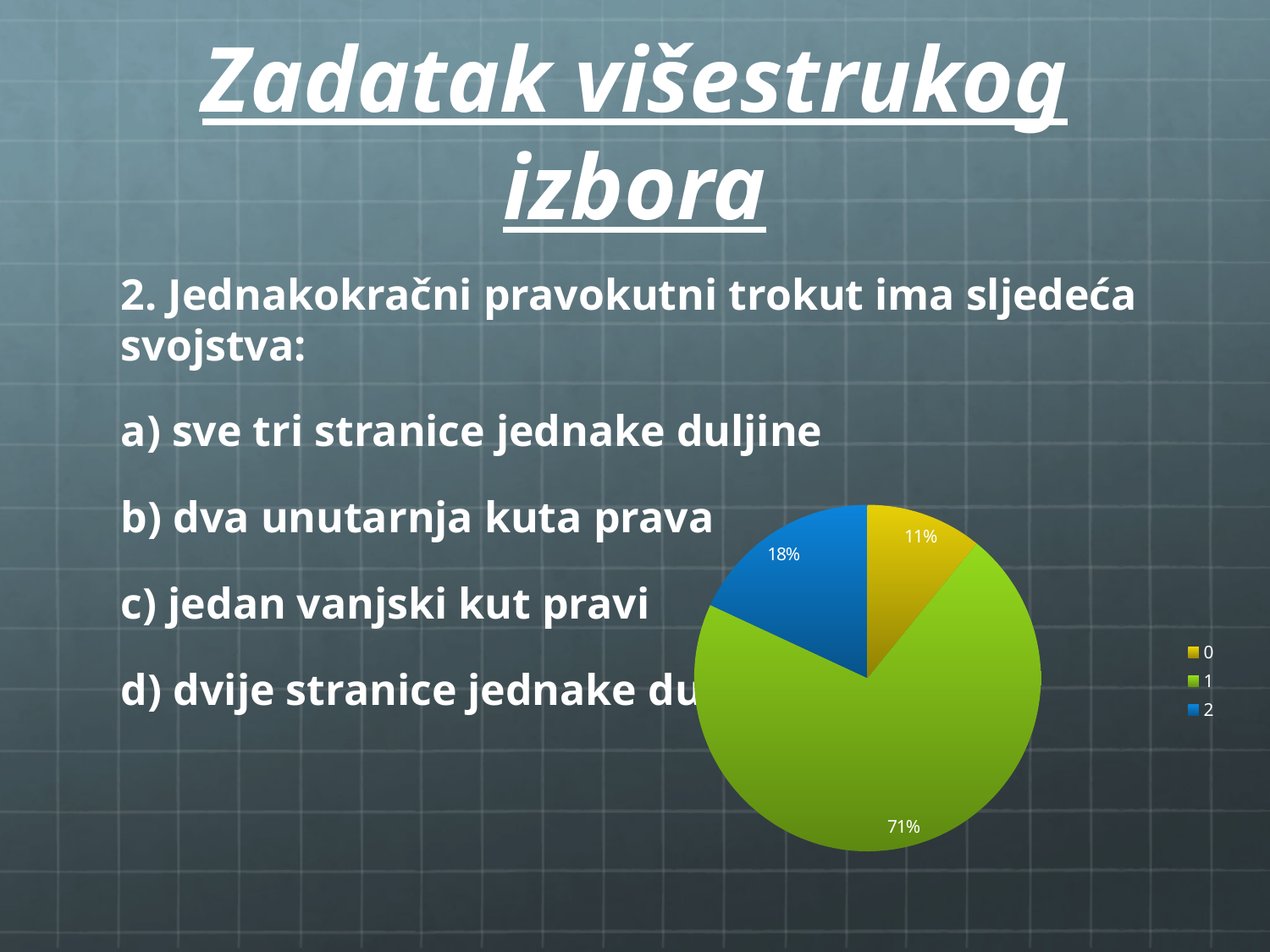
Which is larger, the slice for category 2 or the slice for category 0? 2 Which category has the smallest slice of the pie? 0 What share of the pie does category 2 take? 18% What is the difference in percentage points between the slice for category 2 and the slice for category 0? 7 How many entries does the legend list? 3 What share of the pie does category 1 take? 71% What kind of chart is shown on the slide? pie chart How many slices does the pie chart have? 3 What is the difference in percentage points between the slice for category 1 and the slice for category 2? 53 What colour is the slice for category 1? green Which category has the largest slice of the pie? 1 What share of the pie does category 0 take? 11%